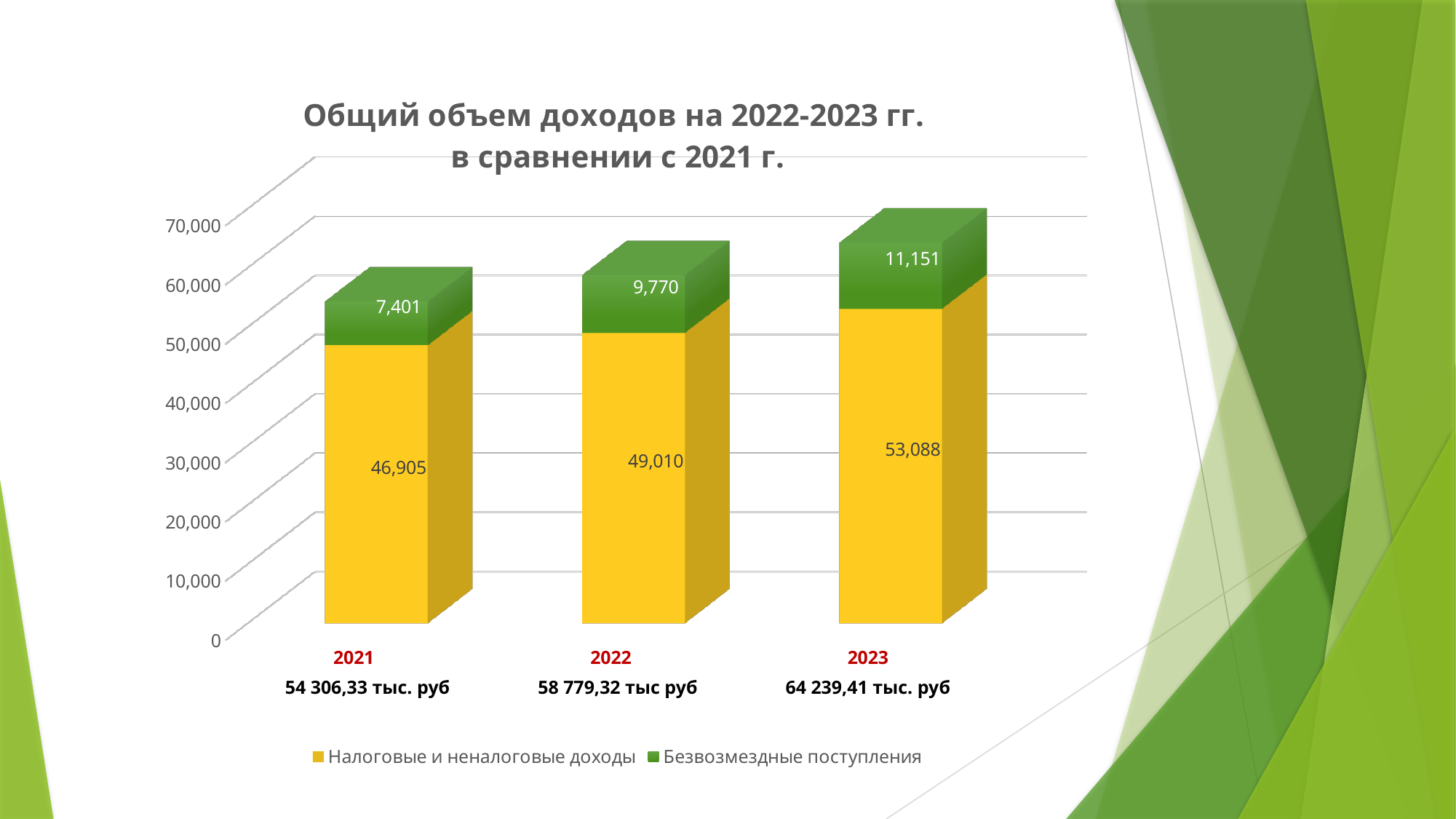
How many series does the legend list? 2 What is the difference between the Безвозмездные поступления values for 2023 and 2021? 3,750 What is the value of Безвозмездные поступления for 2023? 11,151 What total amount is printed below the 2022 bar? 58 779,32 тыс руб Which year has the highest value for Налоговые и неналоговые доходы? 2023 Do the Налоговые и неналоговые доходы values rise or fall from 2021 to 2023? rise Which is larger: Безвозмездные поступления in 2022 or in 2023? 2023 What is the value of Налоговые и неналоговые доходы for 2021? 46,905 What is the difference between the Налоговые и неналоговые доходы values for 2023 and 2021? 6,183 How many years are shown on the x axis? 3 What is the value of Безвозмездные поступления for 2022? 9,770 Which year has the lowest value for Безвозмездные поступления? 2021